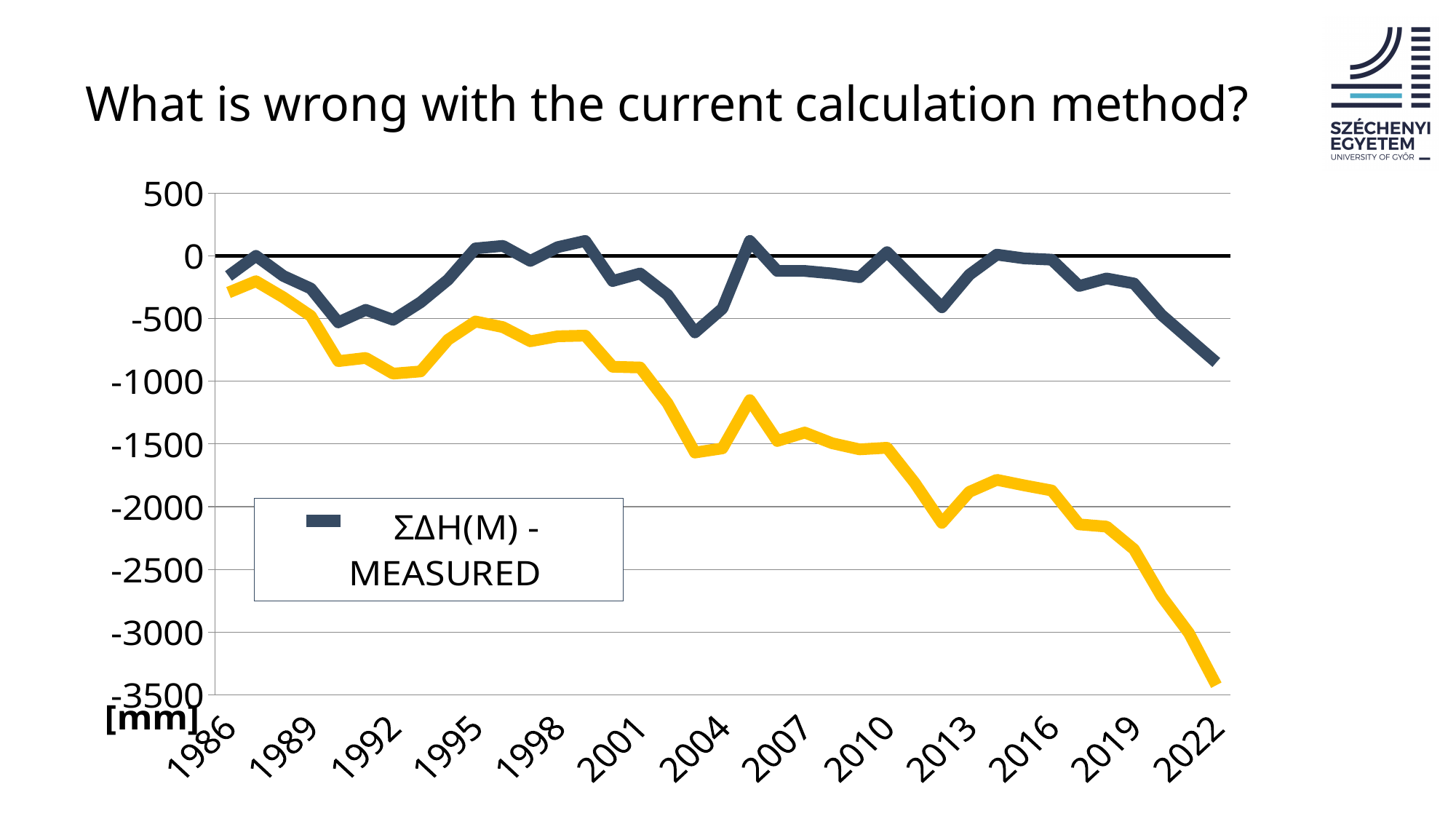
What is the name of the series listed in the legend? ΣΔH(M) - MEASURED Does the yellow line rise or fall overall from 1986 to 2022? fall Is the value of the ΣΔH(M) - MEASURED line at 2022 greater or less than -500? less Is the value of the ΣΔH(M) - MEASURED line at 2019 greater or less than -500? greater Is the value of the yellow line at 2022 greater or less than -3000? less How many series does the chart's legend list? 1 What kind of chart is shown on the slide? line chart How many year labels are shown on the x axis? 13 At 2022, which line is lower: the yellow line or the ΣΔH(M) - MEASURED line? the yellow line What unit is shown for the vertical axis? [mm]